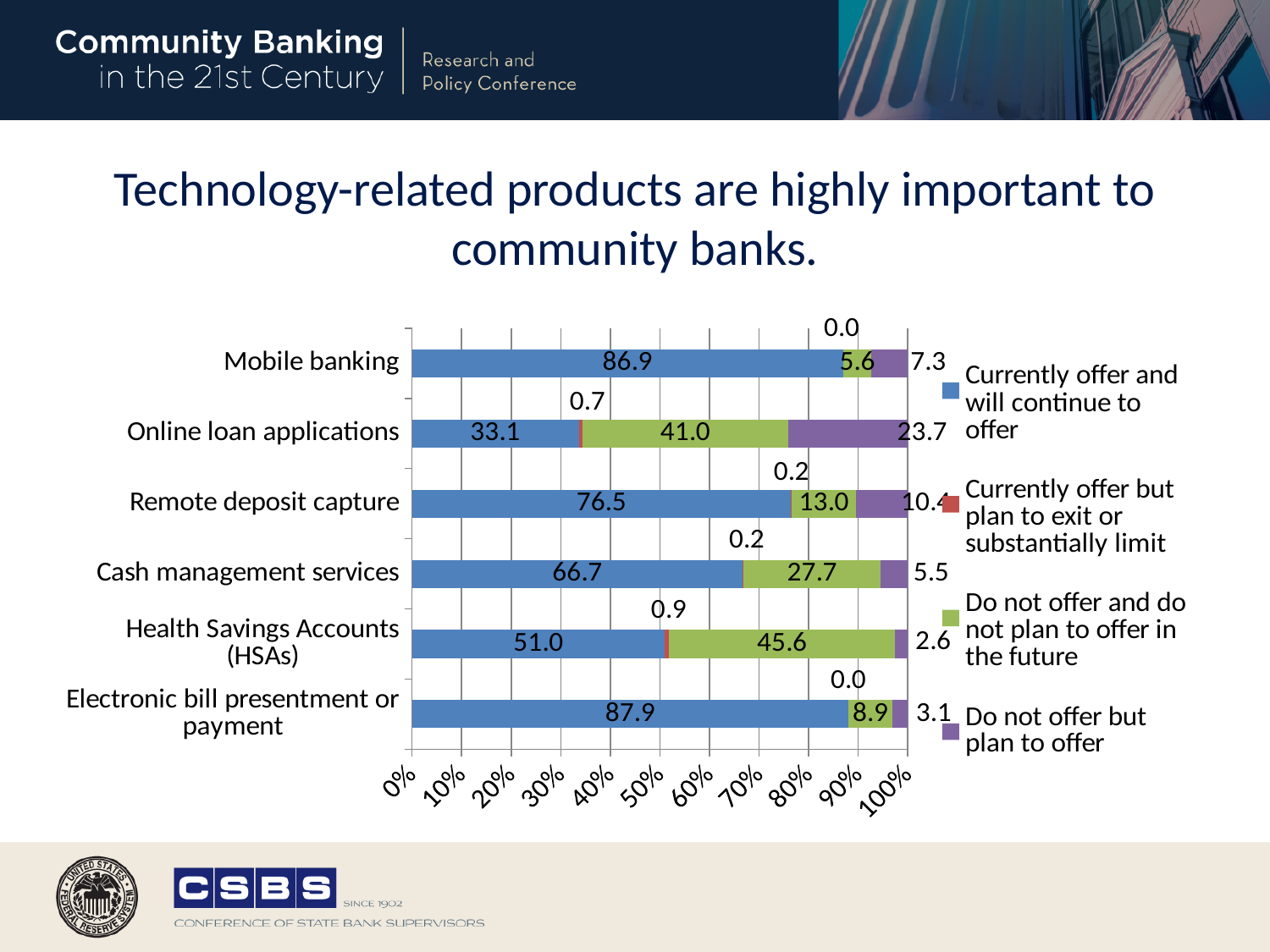
What is the difference between the 'Do not offer and do not plan to offer in the future' values for online loan applications and cash management services? 13.3 Which is larger: the 'Currently offer and will continue to offer' value for remote deposit capture or for cash management services? Remote deposit capture What is the value for 'Do not offer but plan to offer' for online loan applications? 23.7 Which product has the highest value for 'Do not offer and do not plan to offer in the future'? Health Savings Accounts (HSAs) What is the value for 'Currently offer but plan to exit or substantially limit' for cash management services? 0.2 Which product has the lowest value for 'Currently offer and will continue to offer'? Online loan applications How many series does the legend list? 4 What percentage of community banks currently offer and will continue to offer mobile banking? 86.9 What kind of chart is shown on the slide? Stacked bar chart Which product has the highest value for 'Currently offer and will continue to offer'? Electronic bill presentment or payment What is the value for 'Do not offer and do not plan to offer in the future' for Health Savings Accounts (HSAs)? 45.6 How many products are shown on the chart? 6